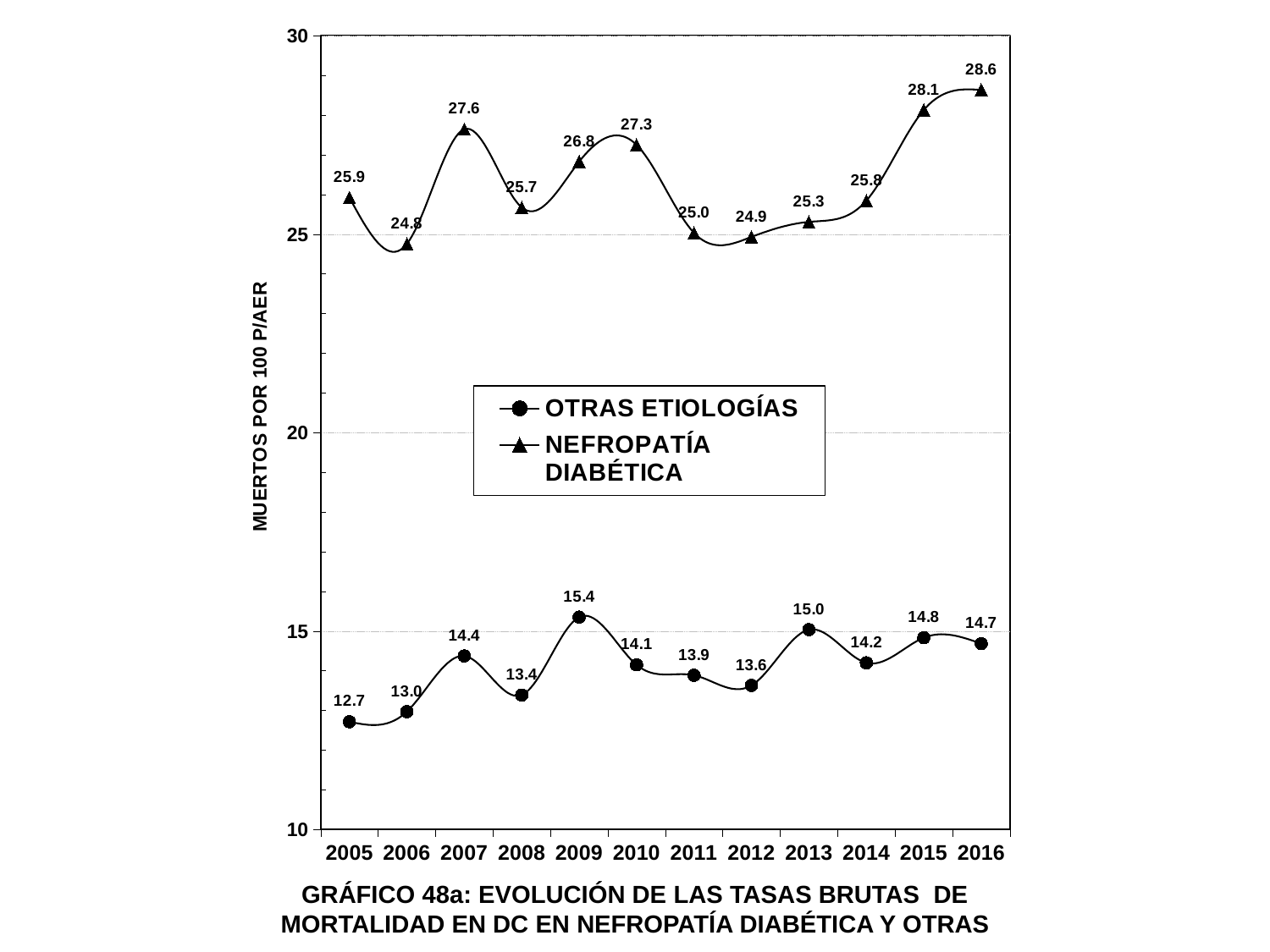
In which year is the NEFROPATÍA DIABÉTICA series highest? 2016 What kind of chart is shown? line chart Is the value for NEFROPATÍA DIABÉTICA in 2012 greater or less than 25? less How many series does the legend list? 2 What is the value for NEFROPATÍA DIABÉTICA in 2016? 28.6 What is the difference between NEFROPATÍA DIABÉTICA and OTRAS ETIOLOGÍAS in 2005? 13.2 What is the label of the y axis? MUERTOS POR 100 P/AER Which is larger for OTRAS ETIOLOGÍAS: the value in 2013 or the value in 2014? 2013 What is the value for OTRAS ETIOLOGÍAS in 2009? 15.4 In which year is the OTRAS ETIOLOGÍAS series lowest? 2005 What is the value for NEFROPATÍA DIABÉTICA in 2006? 24.8 How many years are shown on the x axis? 12